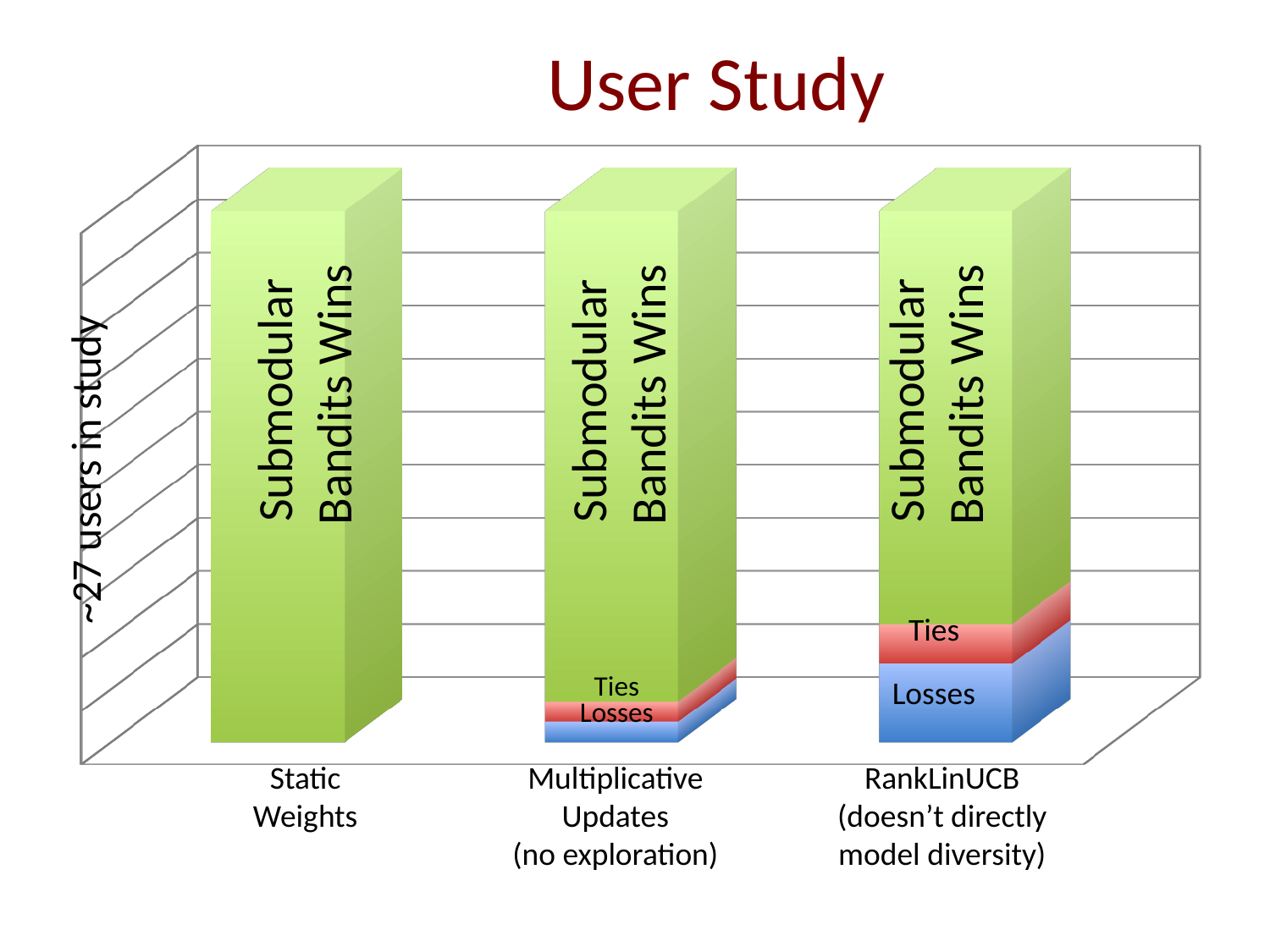
Which category has the smallest 'Submodular Bandits Wins' segment? RankLinUCB (doesn't directly model diversity) Which category's bar consists only of 'Submodular Bandits Wins', with no Ties or Losses segments? Static Weights What kind of chart is shown on the slide? stacked bar chart Which category has the largest 'Losses' segment? RankLinUCB (doesn't directly model diversity) How many categories are shown along the x axis of the chart? 3 Is the 'Ties' segment larger for Multiplicative Updates (no exploration) or for RankLinUCB (doesn't directly model diversity)? RankLinUCB (doesn't directly model diversity) What is the title of the chart on the slide? User Study Which category has the largest 'Submodular Bandits Wins' segment? Static Weights What is the label on the vertical axis of the chart? ~27 users in study Does the 'Submodular Bandits Wins' segment rise or fall moving from Static Weights to RankLinUCB along the x axis? fall Is the 'Losses' segment larger for Multiplicative Updates (no exploration) or for RankLinUCB (doesn't directly model diversity)? RankLinUCB (doesn't directly model diversity) How many segments make up the bar for RankLinUCB (doesn't directly model diversity)? 3